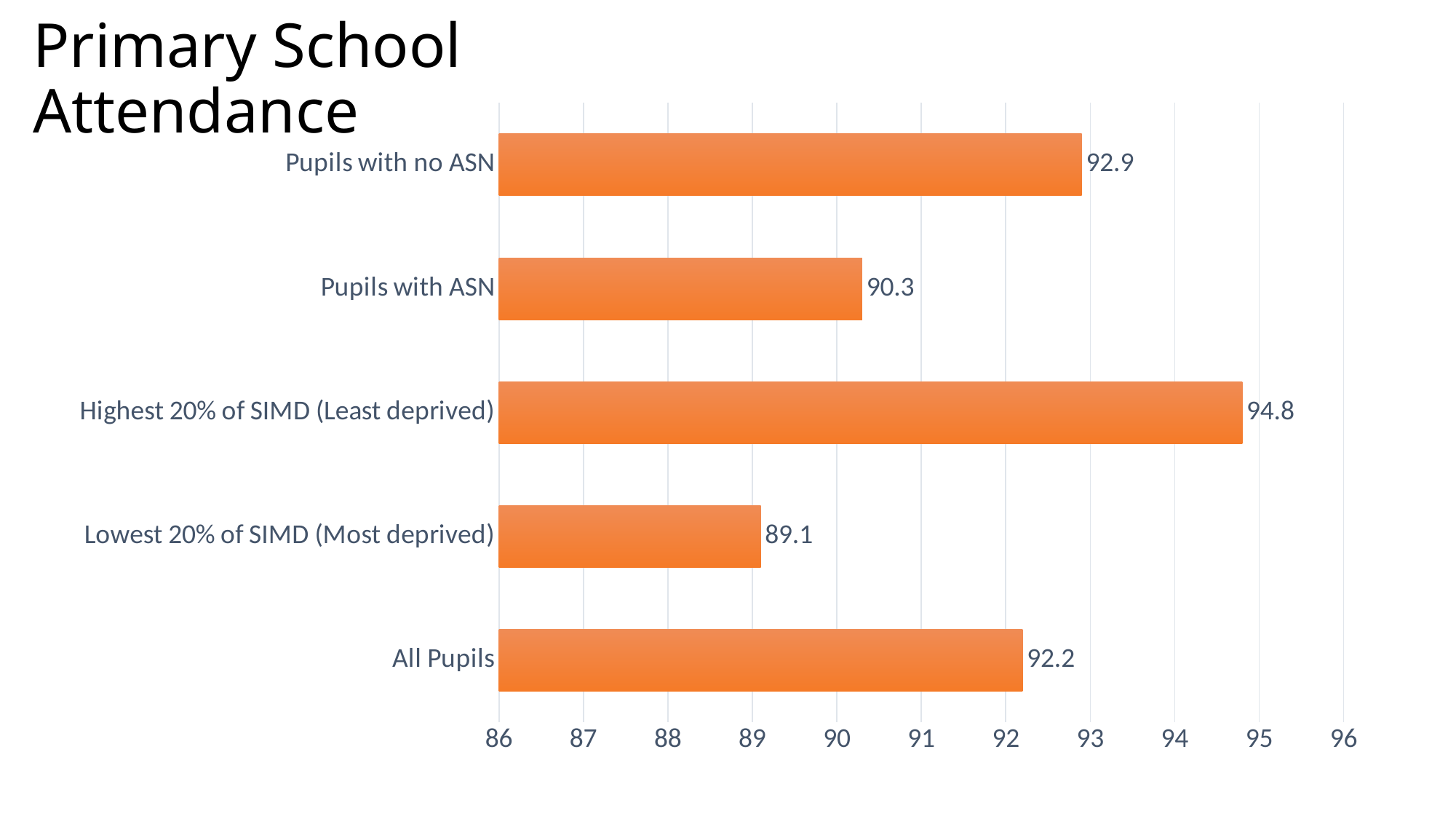
What is the attendance value for Lowest 20% of SIMD (Most deprived)? 89.1 What kind of chart is shown on the slide? bar chart Which category has the highest attendance value? Highest 20% of SIMD (Least deprived) What is the attendance value for Pupils with no ASN? 92.9 What is the attendance value for All Pupils? 92.2 What is the attendance value for Pupils with ASN? 90.3 Which has a higher attendance value, Pupils with no ASN or All Pupils? Pupils with no ASN Is the value for Pupils with ASN greater or less than 91? less What is the difference between the attendance values for Highest 20% of SIMD (Least deprived) and Lowest 20% of SIMD (Most deprived)? 5.7 What is the difference between the attendance values for Pupils with no ASN and Pupils with ASN? 2.6 How many categories are shown in the chart? 5 Which category has the lowest attendance value? Lowest 20% of SIMD (Most deprived)